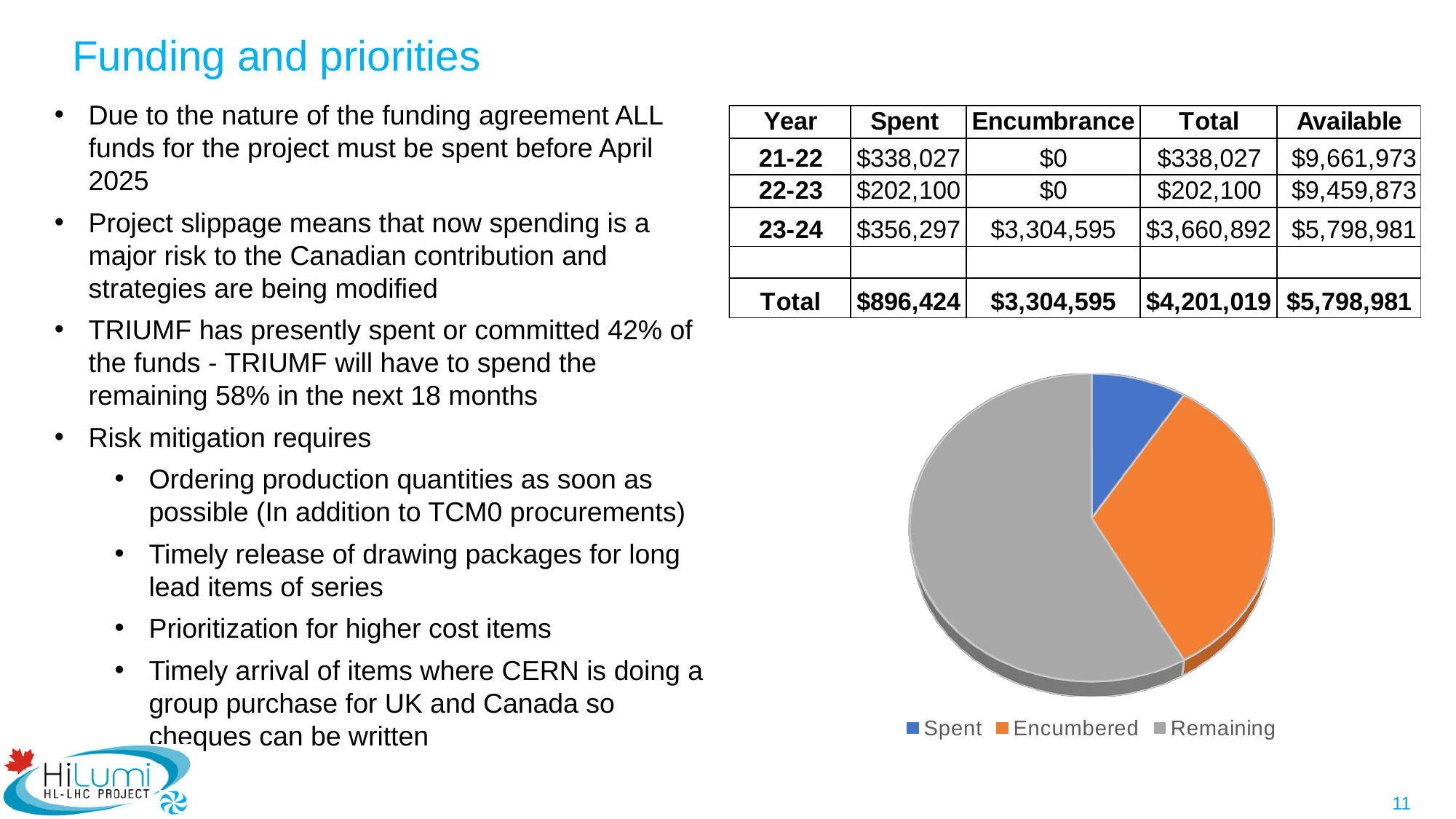
In the pie chart, which slice is larger: Encumbered or Spent? Encumbered How many slices does the pie chart have? 3 In the pie chart, which slice is larger: Remaining or Encumbered? Remaining Which category has the largest slice in the pie chart? Remaining What colour is the Encumbered slice in the pie chart? Orange Is the Spent slice greater or less than a quarter of the pie? less Which category has the smallest slice in the pie chart? Spent How many entries does the pie chart's legend list? 3 What kind of chart is shown on the slide? Pie chart Which category is shown in grey in the pie chart? Remaining Is the Remaining slice greater or less than half of the pie? greater